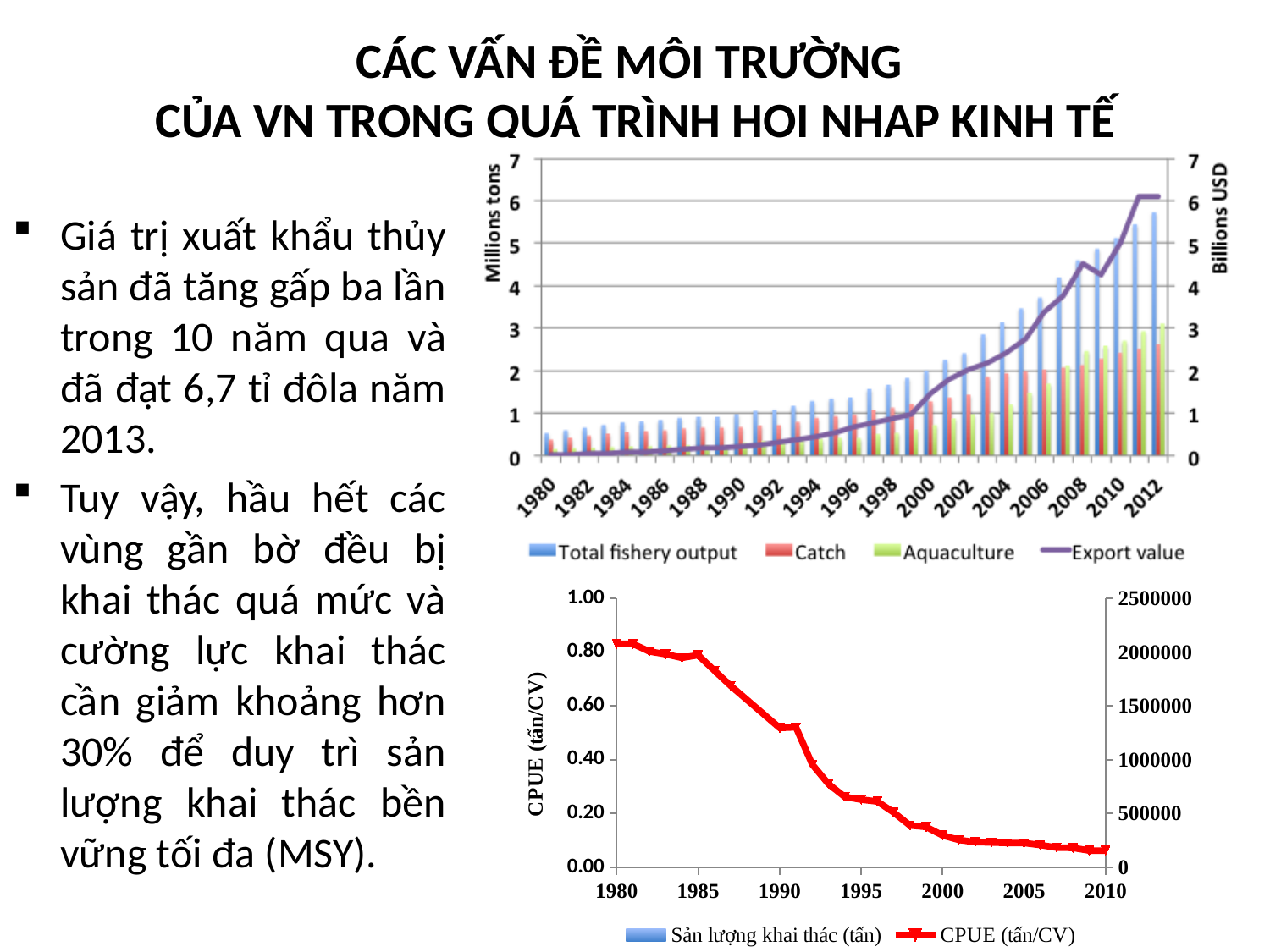
In the top chart, how many series does the legend list? 4 In the top chart, which series is drawn as a line rather than bars? Export value In the top chart, is the Export value for 2012 greater or less than 5? greater In the top chart, does the Export value line generally rise or fall from 1980 to 2012? rise In the top chart, is the Catch value for 2012 greater or less than 2? greater In the top chart, is the Total fishery output for 2012 greater or less than 5? greater In the top chart, what is the unit shown on the right-hand axis? Billions USD In the bottom chart, does the CPUE (tấn/CV) line rise or fall from 1980 to 2010? fall In the bottom chart, how many series does the legend list? 2